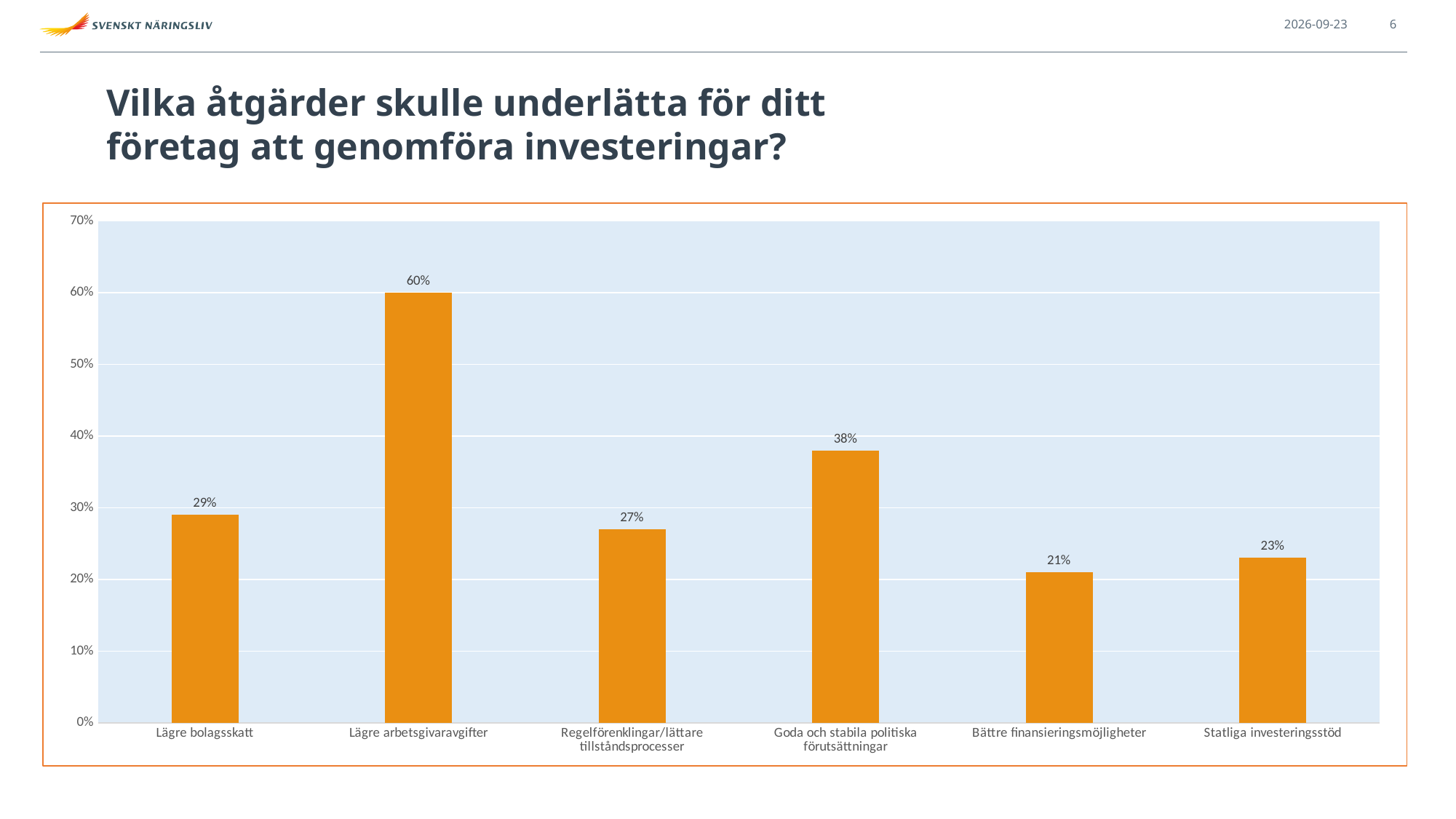
Is the value for Goda och stabila politiska förutsättningar greater or less than 40%? less What is the difference between the values for Lägre arbetsgivaravgifter and Goda och stabila politiska förutsättningar? 22% What is the value for Statliga investeringsstöd? 23% What is the value for Goda och stabila politiska förutsättningar? 38% What is the highest value shown on the vertical axis? 70% What is the value for Lägre arbetsgivaravgifter? 60% How many categories are shown in the chart? 6 Which category has the lowest value? Bättre finansieringsmöjligheter Which category has the highest value? Lägre arbetsgivaravgifter Which is larger, the value for Lägre bolagsskatt or the value for Statliga investeringsstöd? Lägre bolagsskatt What kind of chart is shown on the slide? bar chart What is the difference between the values for Lägre bolagsskatt and Regelförenklingar/lättare tillståndsprocesser? 2%